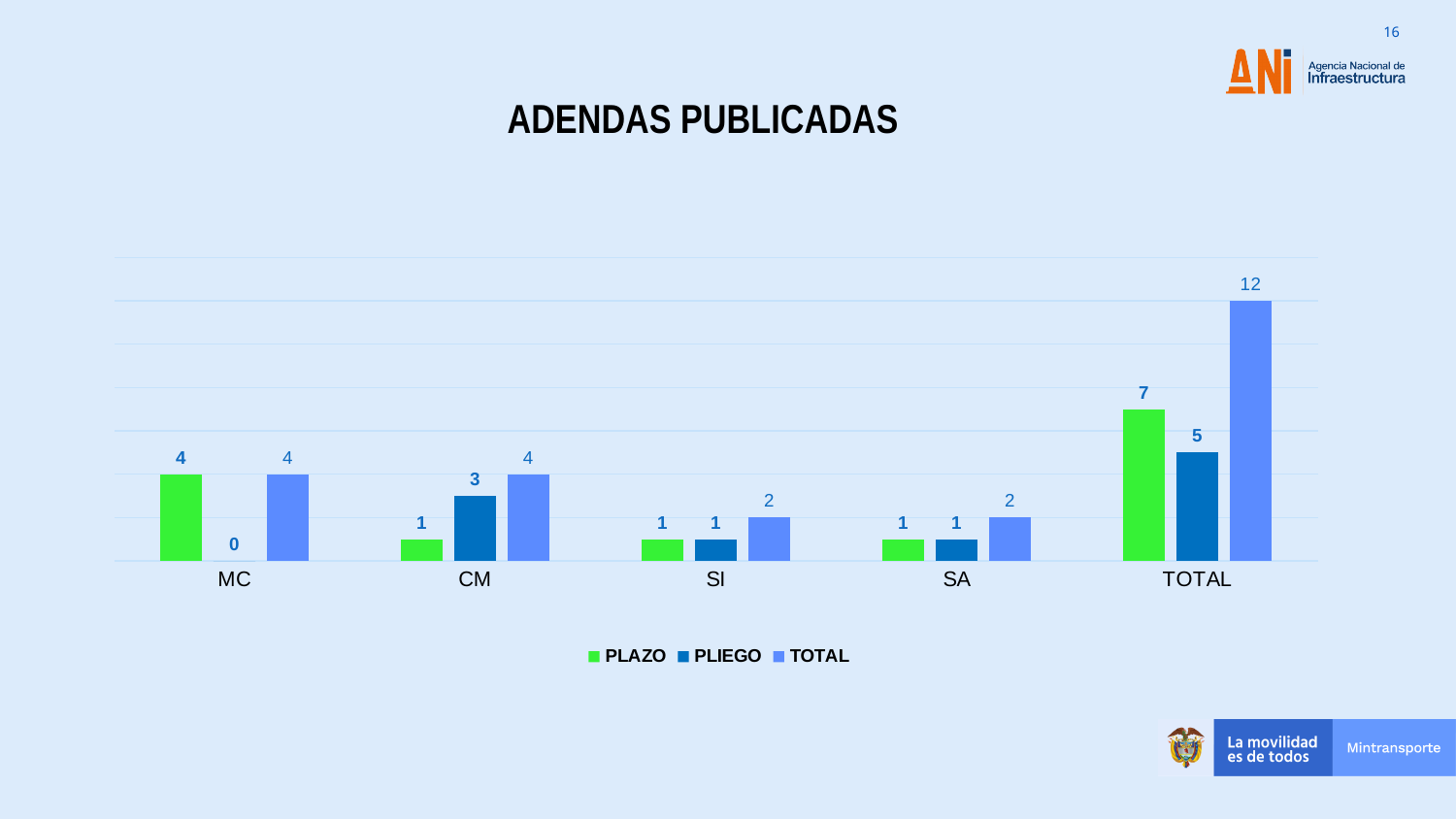
How many series does the legend list? 3 Which category has the highest TOTAL value? TOTAL What kind of chart is shown on the slide? Bar chart Which is larger, the PLAZO value for MC or the PLAZO value for CM? PLAZO value for MC What is the difference between the PLAZO and PLIEGO values for the TOTAL category? 2 What is the PLAZO value for MC? 4 What is the PLIEGO value for MC? 0 What is the TOTAL value for SI? 2 Which category has the lowest PLIEGO value? MC What is the PLIEGO value for CM? 3 What is the title of the chart? ADENDAS PUBLICADAS How many categories are shown on the x axis? 5